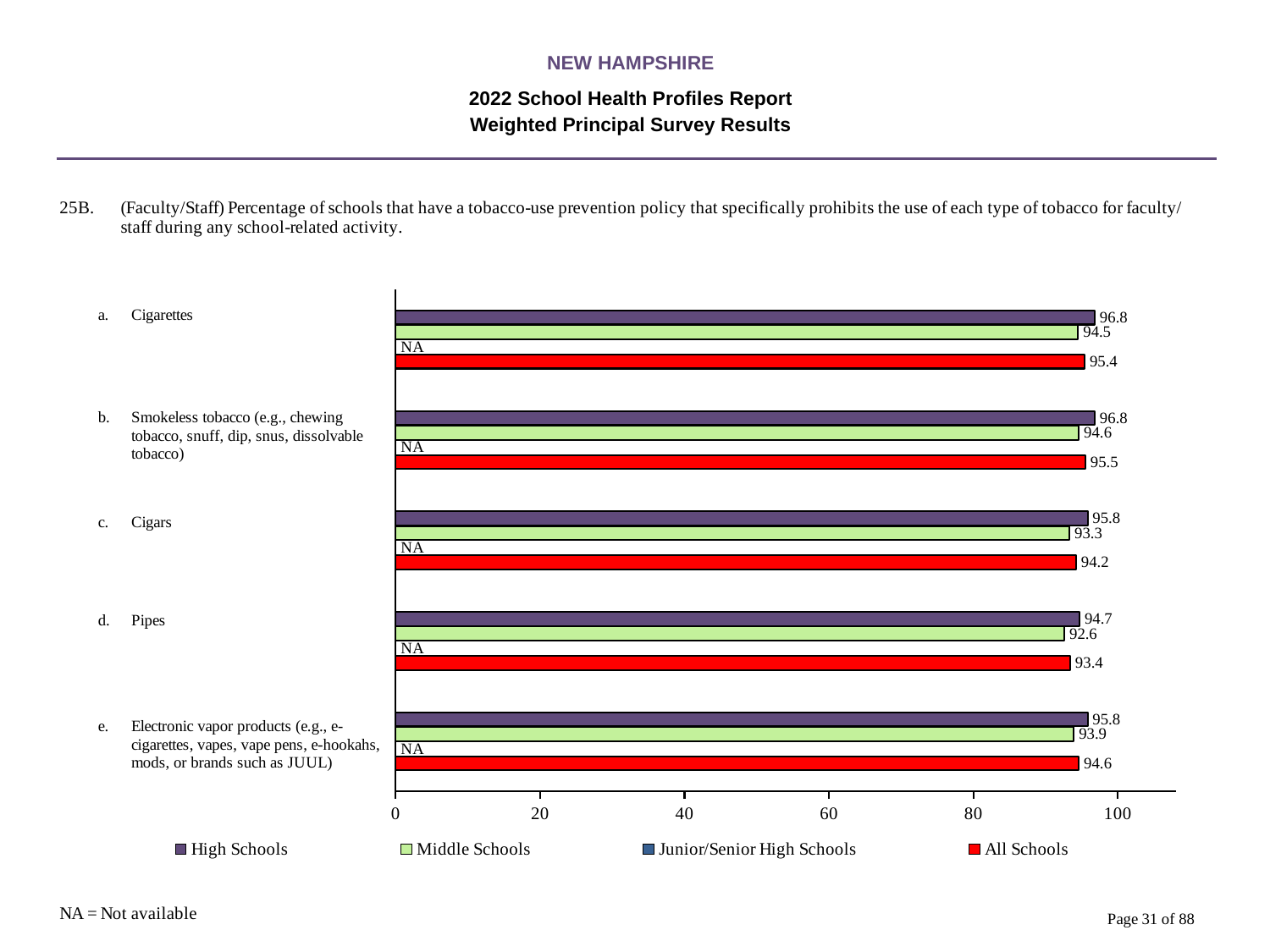
What is the value for Junior/Senior High Schools for Cigars? NA What colour are the All Schools bars? Red What is the value for All Schools for Pipes? 93.4 How many categories are shown on the chart? 5 How many series does the legend list? 4 Which category has the lowest value for Middle Schools? Pipes What is the value for High Schools for Cigarettes? 96.8 Which category has the highest value for All Schools? Smokeless tobacco What is the value for Middle Schools for Electronic vapor products? 93.9 What is the difference between the High Schools and Middle Schools values for Cigars? 2.5 What kind of chart is shown on the slide? Bar chart Which is larger for Pipes: the High Schools value or the All Schools value? High Schools